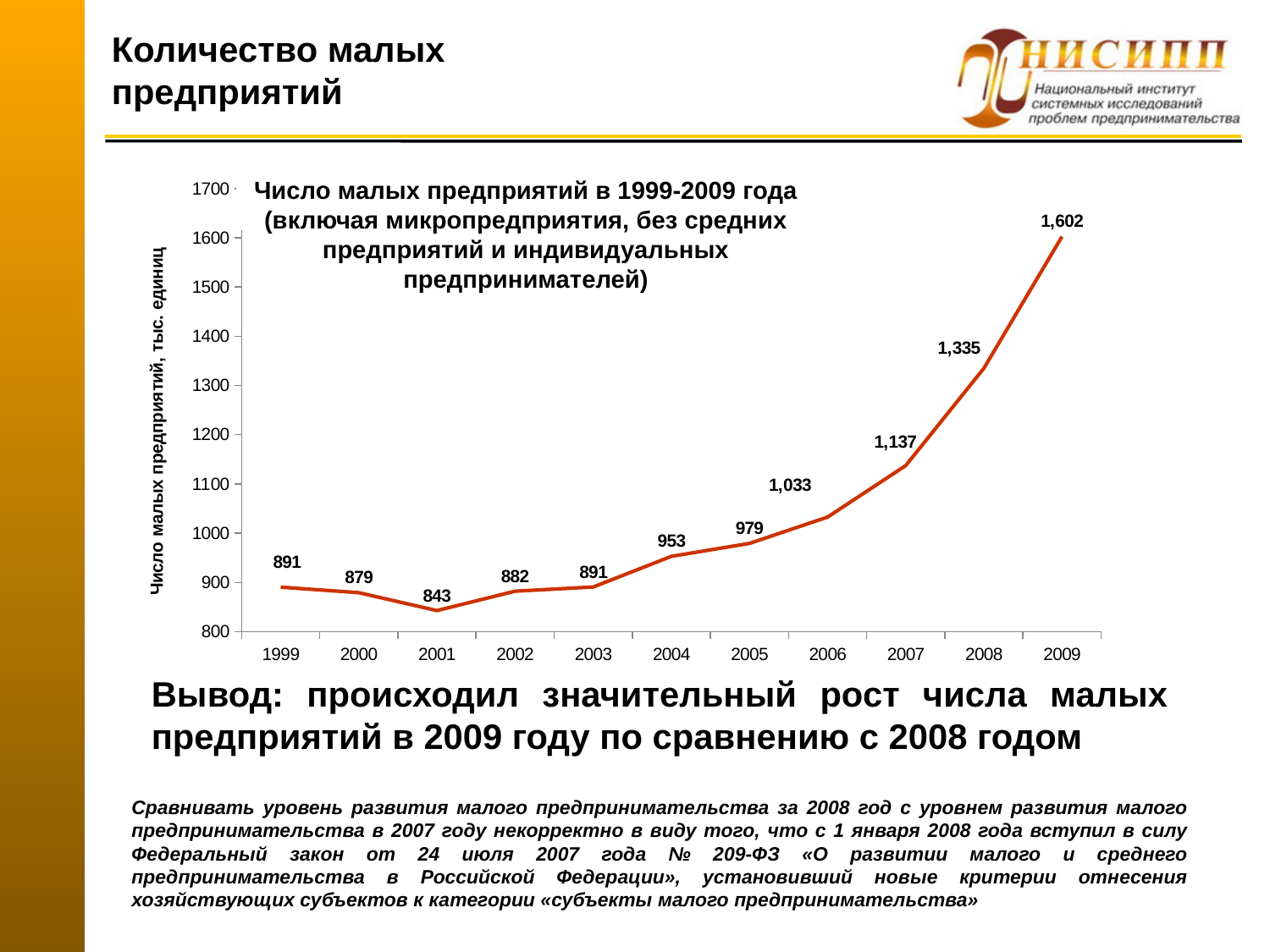
Is the value for 2008 greater or less than 1300? greater Which year has the lowest value? 2001 How many years are plotted on the chart? 11 What is the difference between the values for 2009 and 2008? 267 Which year has the highest value? 2009 Do the values rise or fall from 2003 to 2009? rise What is the difference between the values for 2007 and 2006? 104 What kind of chart is shown on the slide? line chart What is the value for 2001? 843 Which is larger, the value for 2000 or the value for 2002? 2002 What is the value for 2009? 1,602 What is the value for 2005? 979